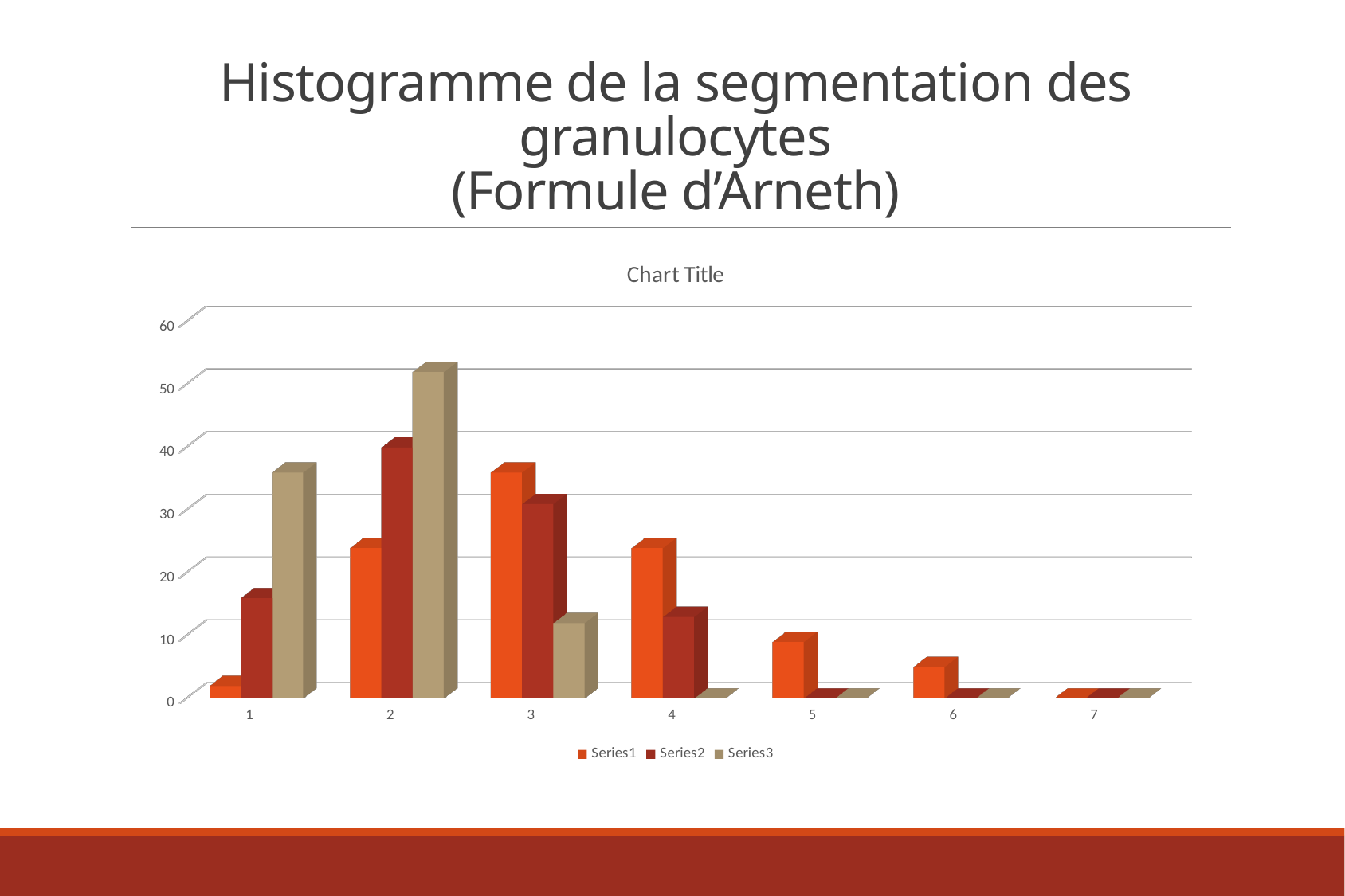
At category 1, which series has the larger value, Series1 or Series3? Series3 How many series does the legend list? 3 How many categories are shown on the x axis? 7 What kind of chart is shown on the slide? bar chart Do the Series1 values rise or fall from category 3 to category 7? fall Which category has the highest value for Series3? 2 What is the title shown above the chart? Chart Title Is the value for Series2 at category 1 greater or less than 20? less Which category has the highest value for Series2? 2 Which category has the highest value for Series1? 3